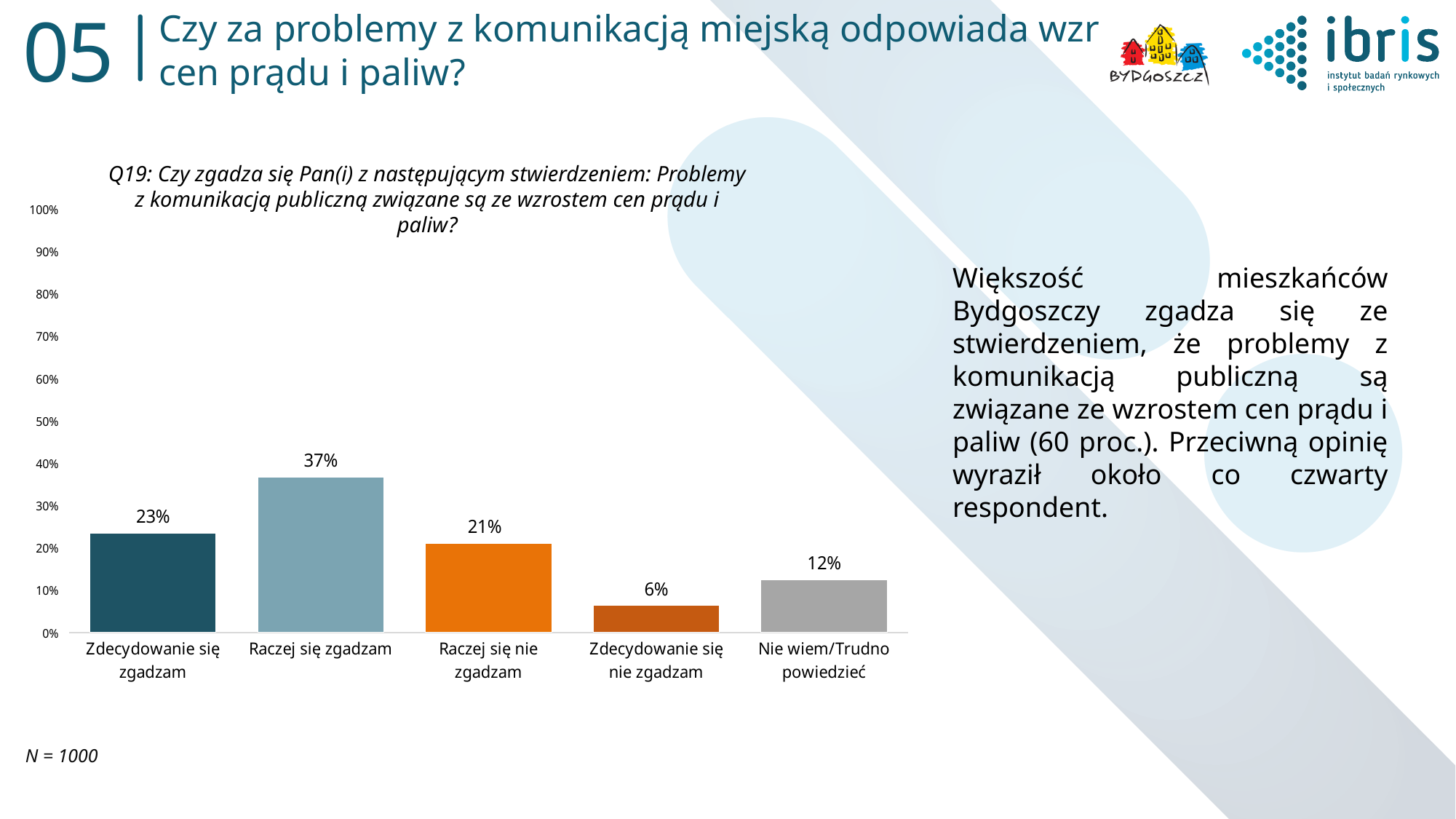
Which category has the lowest value? Zdecydowanie się nie zgadzam What is the value for "Zdecydowanie się nie zgadzam"? 6% What is the sample size (N) stated below the chart? N = 1000 What kind of chart is shown on the slide? bar chart What is the value for "Raczej się zgadzam"? 37% Which is larger: "Zdecydowanie się zgadzam" or "Raczej się nie zgadzam"? Zdecydowanie się zgadzam What is the value for "Nie wiem/Trudno powiedzieć"? 12% Which category has the highest value? Raczej się zgadzam Is the value for "Raczej się zgadzam" greater or less than 30%? greater What is the difference between "Raczej się zgadzam" and "Raczej się nie zgadzam"? 16% What is the value for "Zdecydowanie się zgadzam"? 23% How many categories are shown in the chart? 5